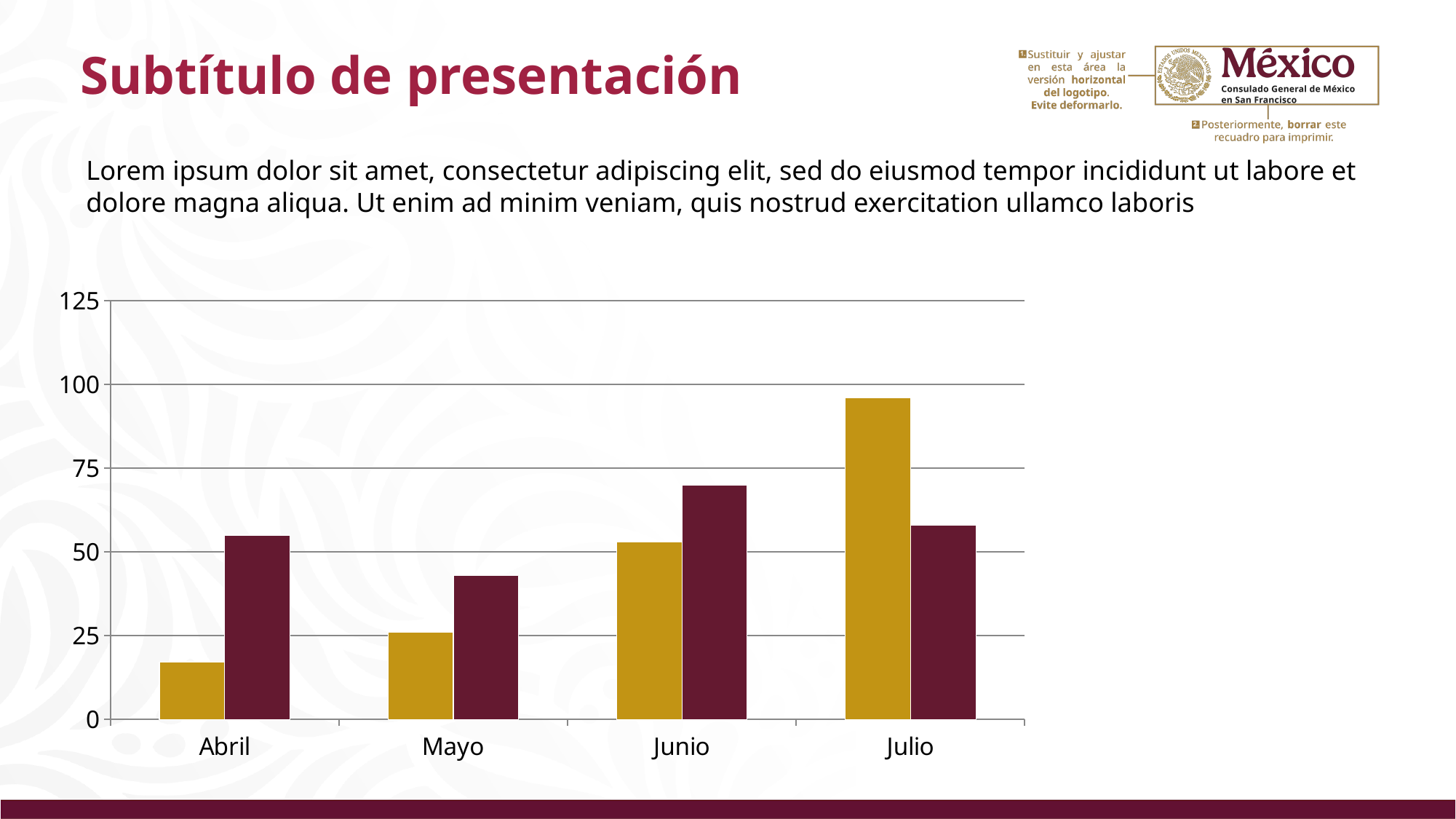
Which month has the shortest maroon bar? Mayo Do the gold bars rise or fall from Abril to Julio? rise Is the value of the gold bar for Julio greater or less than 75? greater Which month has the tallest maroon bar? Junio In Julio, which bar is taller, the gold one or the maroon one? the gold one What kind of chart is shown on the slide? bar chart In Abril, which bar is taller, the gold one or the maroon one? the maroon one How many categories are shown on the x axis of the chart? 4 Which month has the tallest gold bar? Julio Is the value of the gold bar for Abril greater or less than 25? less Which month has the shortest gold bar? Abril Is the value of the maroon bar for Junio greater or less than 50? greater